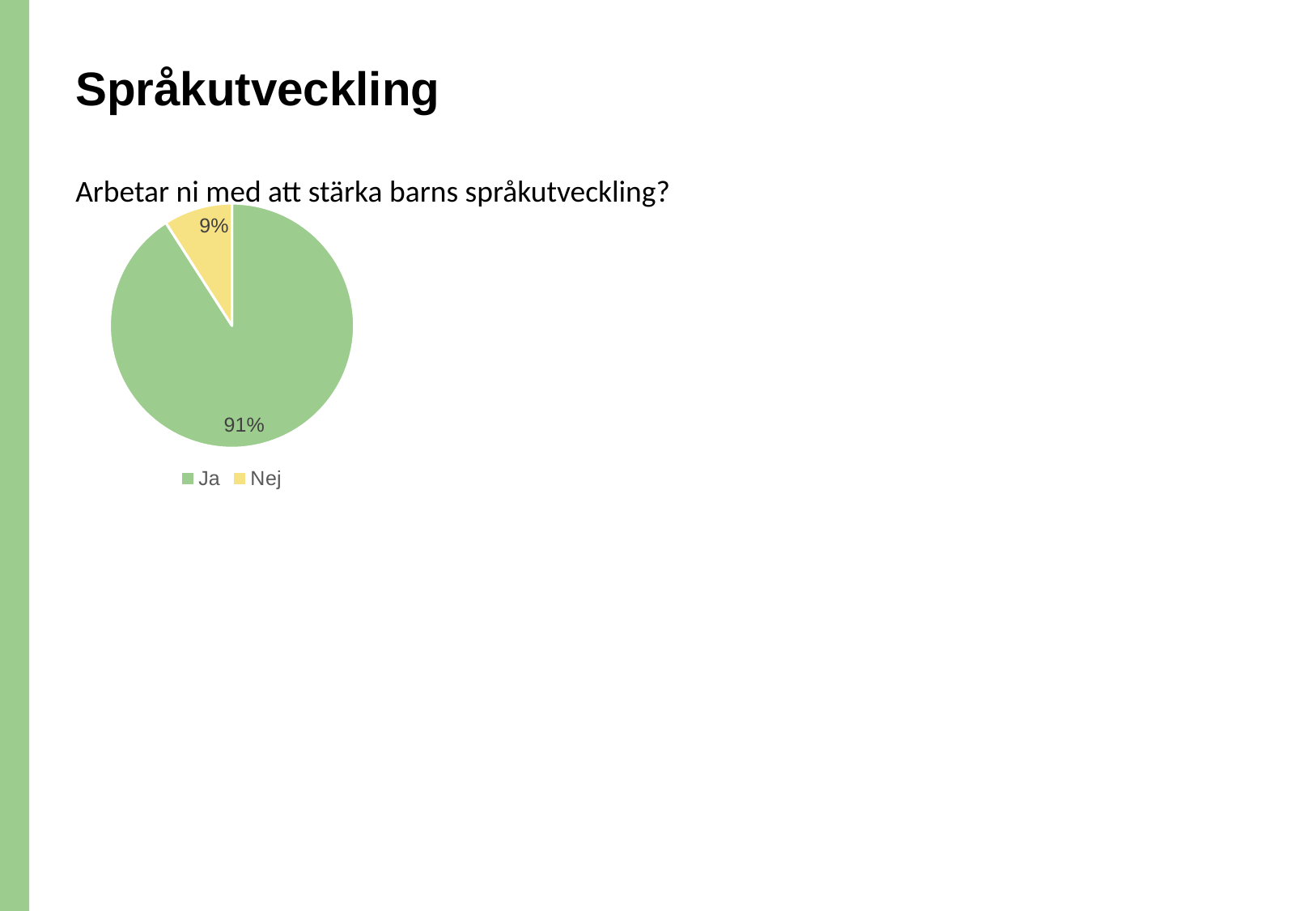
Which slice of the pie is the largest? Ja What is the difference in percentage points between the "Ja" and "Nej" slices? 82 Which is larger, the "Ja" slice or the "Nej" slice? Ja How many entries does the legend list? 2 What colour is the "Nej" slice of the pie? yellow What share of the pie is labelled "Nej"? 9% How many slices does the pie chart have? 2 What question is the pie chart answering, as written above it? Arbetar ni med att stärka barns språkutveckling? What kind of chart is shown on the slide? pie chart Which slice of the pie is the smallest? Nej What share of the pie is labelled "Ja"? 91%